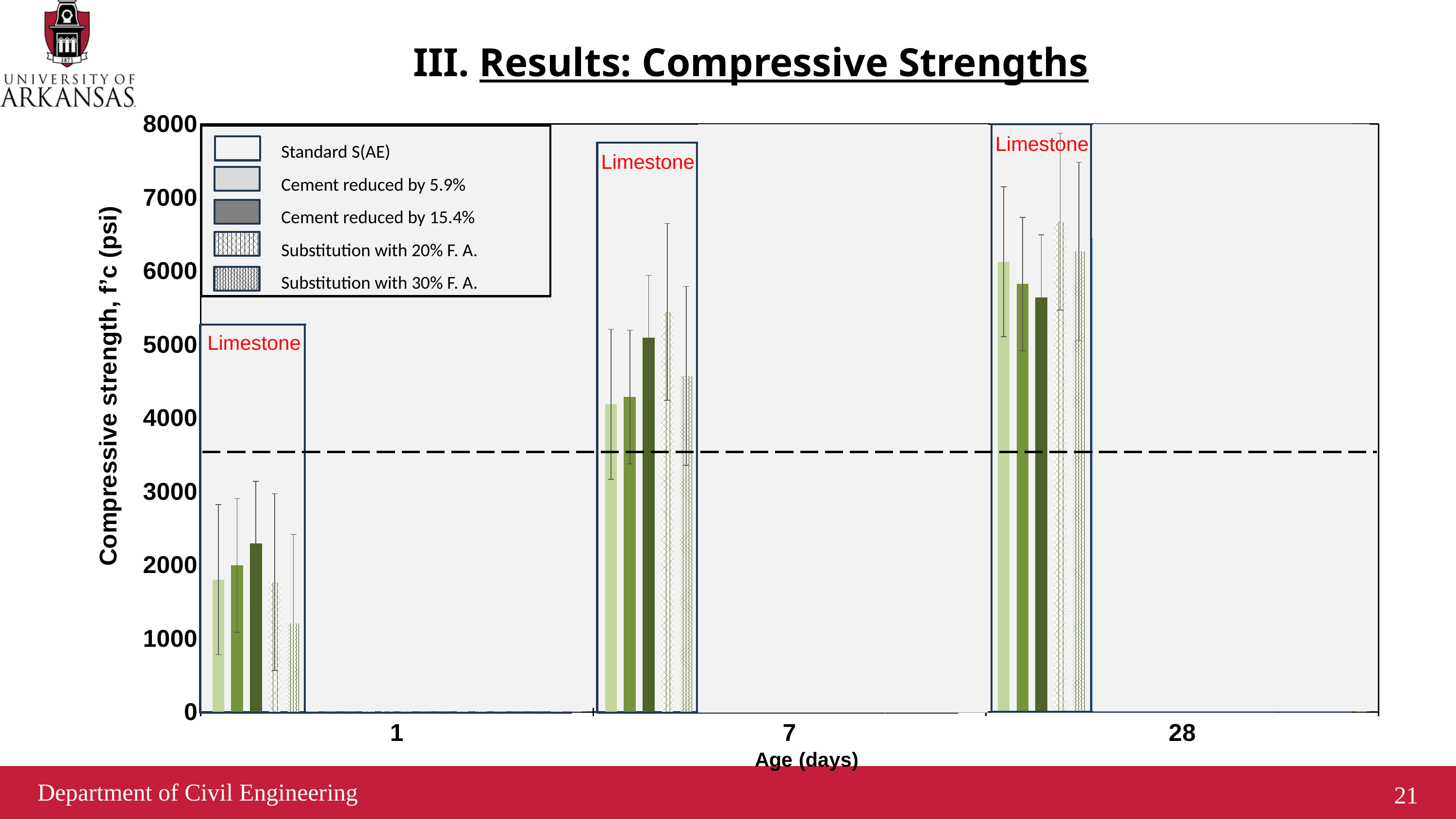
How many age categories are shown on the x axis? 3 Is the value for Cement reduced by 15.4% at 7 days greater or less than 4000? greater How many series does the legend list? 5 Which series has the highest compressive strength at 1 day? Cement reduced by 15.4% Which series has the highest compressive strength at 28 days? Substitution with 20% F. A. What is the label of the y axis? Compressive strength, f'c (psi) Is the value for Standard S(AE) at 28 days greater or less than 5000? greater Which series has the lowest compressive strength at 1 day? Substitution with 30% F. A. What kind of chart is shown on the slide? bar chart What red label appears above each group of bars? Limestone Is the value for Substitution with 30% F. A. at 1 day greater or less than 2000? less Does the compressive strength of Standard S(AE) rise or fall as age increases from 1 to 28 days? rise